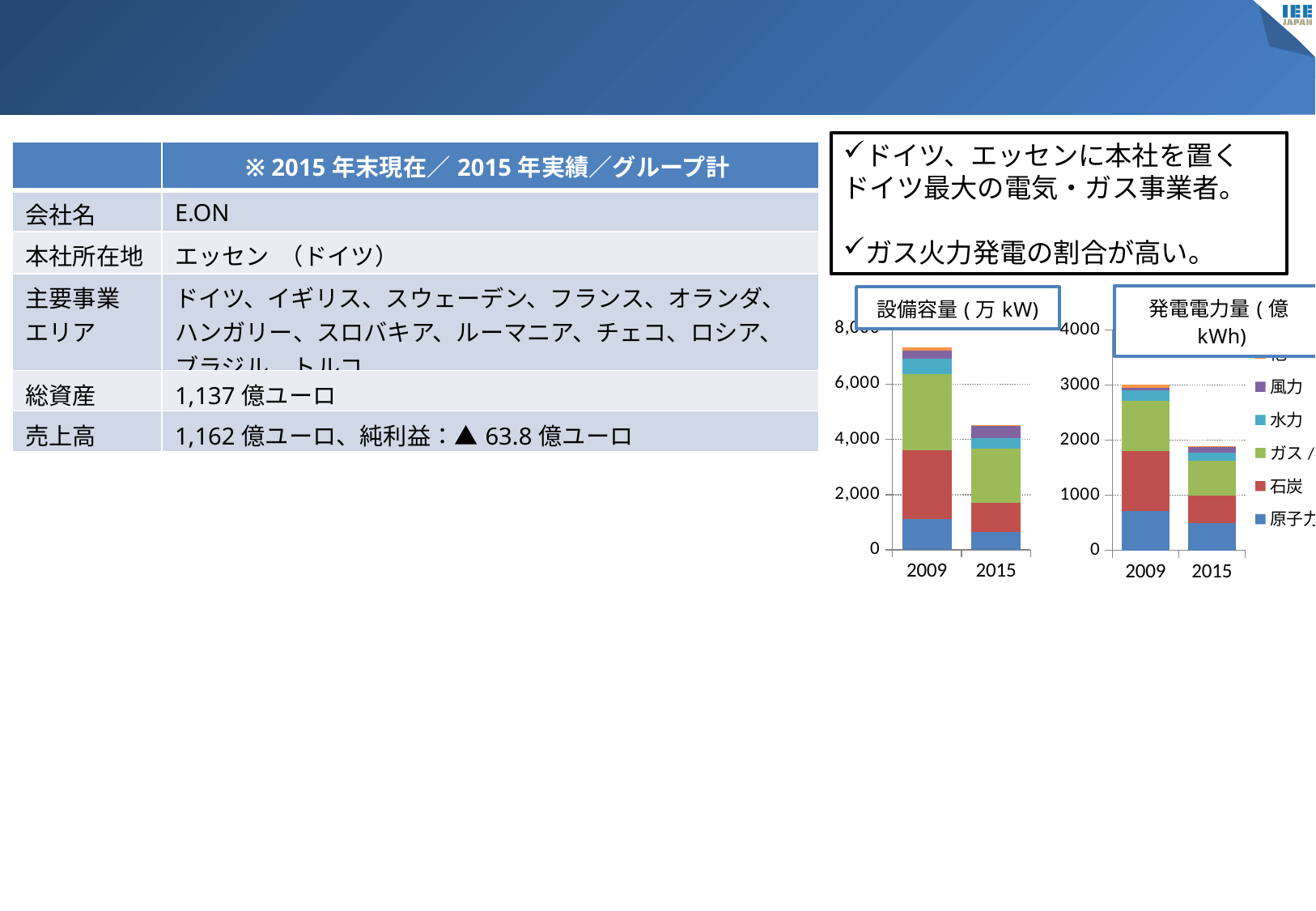
In the 設備容量 (万 kW) chart, which year has the larger total, 2009 or 2015? 2009 In the 設備容量 (万 kW) chart, is the total for 2009 greater or less than 6,000? greater In the 設備容量 (万 kW) chart, how many years are shown on the x axis? 2 What kind of chart is the 設備容量 (万 kW) chart? stacked bar chart In the 発電電力量 (億 kWh) chart, is the total for 2009 greater or less than 2000? greater In the 設備容量 (万 kW) chart, is the total for 2015 greater or less than 4,000? greater In the 設備容量 (万 kW) chart, does the total rise or fall from 2009 to 2015? fall What kind of chart is the 発電電力量 (億 kWh) chart? stacked bar chart In the 発電電力量 (億 kWh) chart, which years are shown on the x axis? 2009 and 2015 In the 発電電力量 (億 kWh) chart, which year has the larger total, 2009 or 2015? 2009